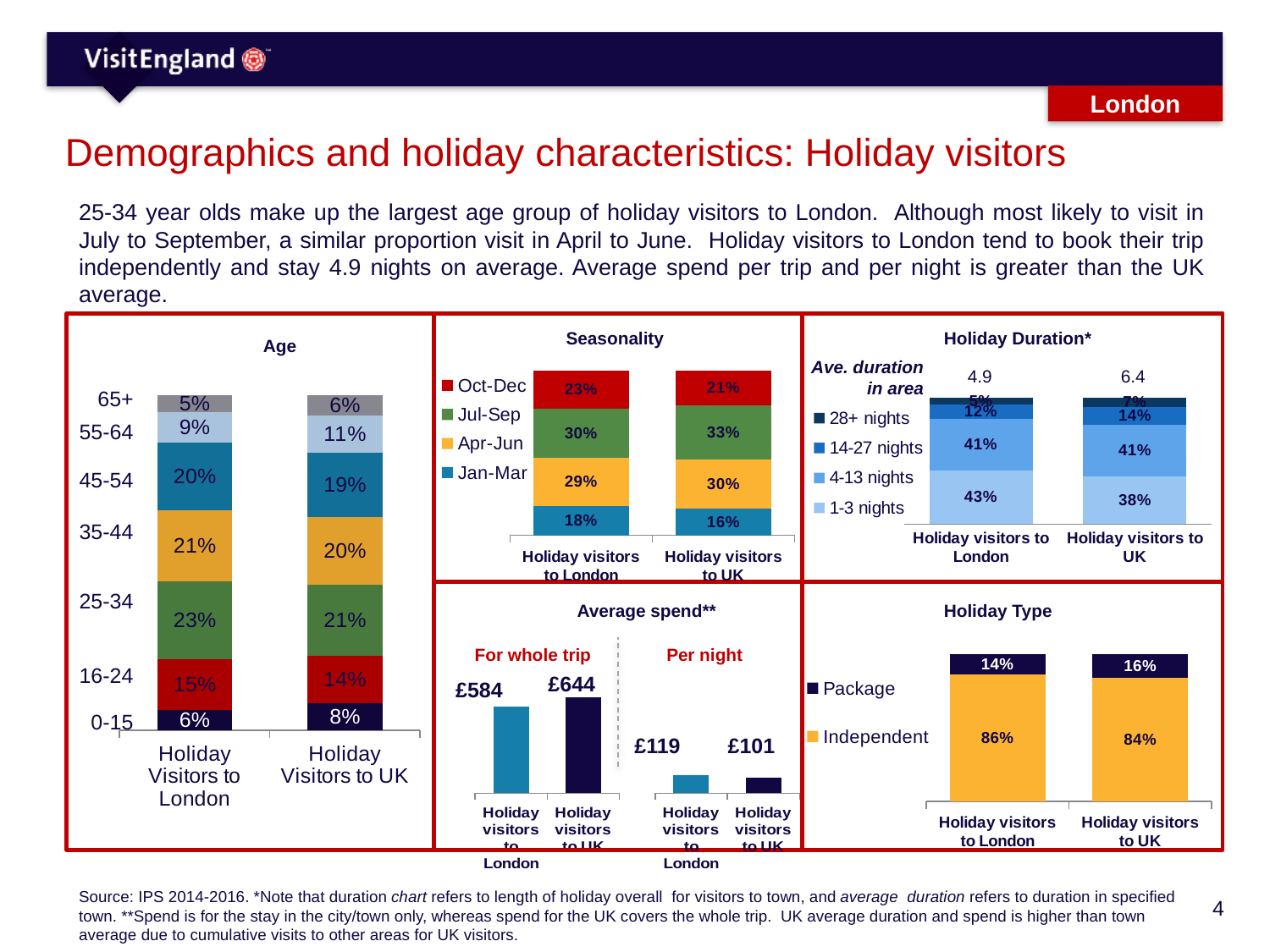
In the Seasonality chart, which is larger: the Jan-Mar share for holiday visitors to London or for holiday visitors to UK? Holiday visitors to London In the Age chart, which age group is the smallest share of holiday visitors to London? 65+ In the Average spend chart, what is the difference in per night spend between holiday visitors to London and holiday visitors to UK? £18 In the Average spend chart, what is the spend for the whole trip for holiday visitors to London? £584 In the Holiday Duration chart, what is the average duration in area for holiday visitors to UK? 6.4 In the Holiday Duration chart, what percentage of holiday visitors to London stay 1-3 nights? 43% In the Seasonality chart, how many series does the legend list? 4 In the Seasonality chart, what percentage of holiday visitors to London visit in Jul-Sep? 30% In the Holiday Type chart, what percentage of holiday visitors to UK book a package holiday? 16% In the Age chart, what percentage of holiday visitors to London are aged 25-34? 23% In the Age chart, what is the difference between the 16-24 share for holiday visitors to London and for holiday visitors to UK? 1% What kind of chart is the Holiday Type chart? Stacked bar chart